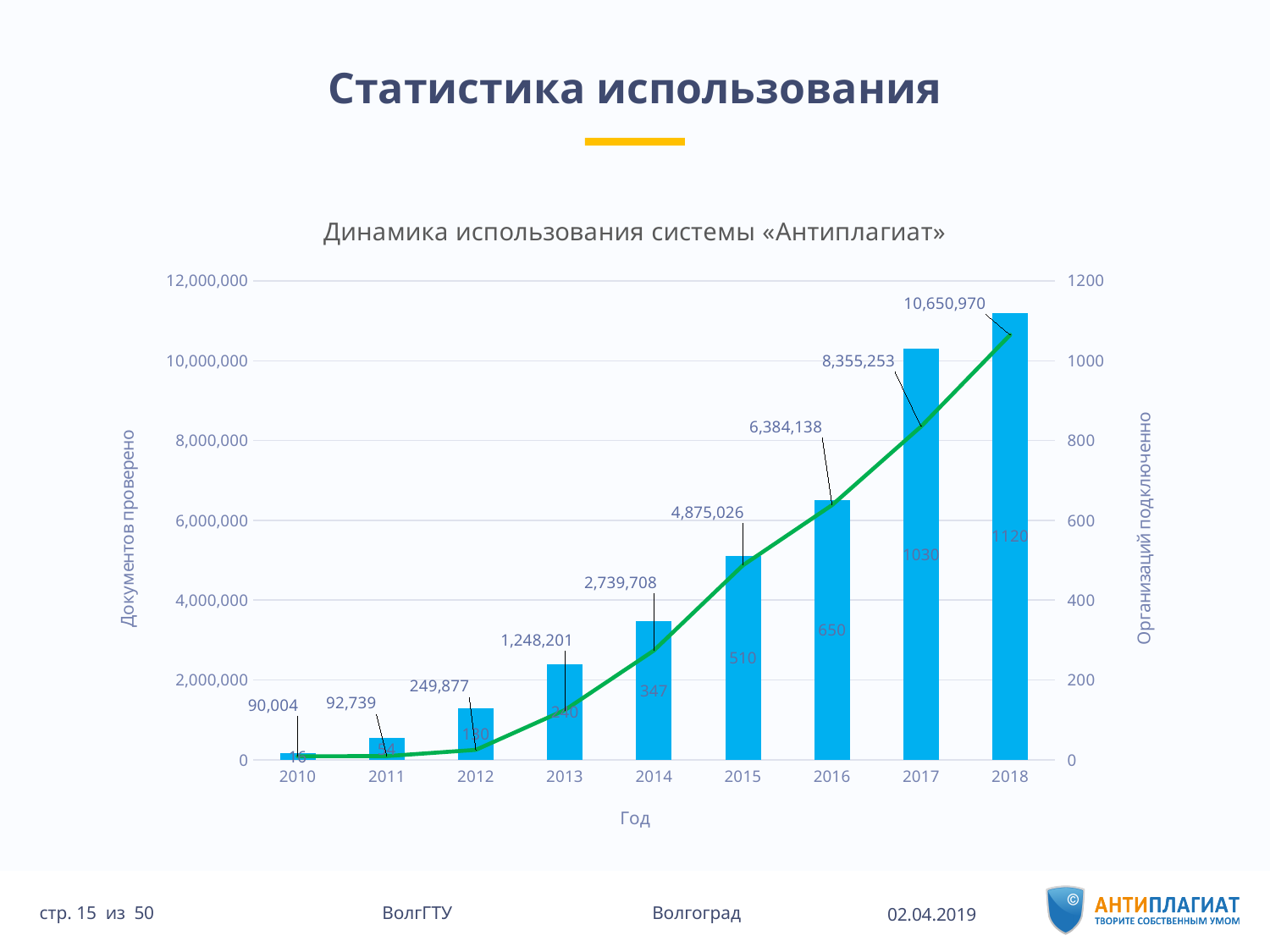
Which year has more organizations connected, 2014 or 2015? 2015 What is the title of the chart? Динамика использования системы «Антиплагиат» What is the difference in documents checked between 2017 and 2016? 1,971,115 What is the number of organizations connected in 2017? 1030 What is the number of documents checked in 2013? 1,248,201 Does the number of documents checked rise or fall from 2010 to 2018? rise How many years are shown on the x axis? 9 Which year has the lowest number of documents checked? 2010 What is the difference in organizations connected between 2018 and 2017? 90 What is the number of documents checked (Документов проверено) in 2018? 10,650,970 Which year has the highest number of documents checked? 2018 What is the number of organizations connected (Организаций подключенно) in 2016? 650